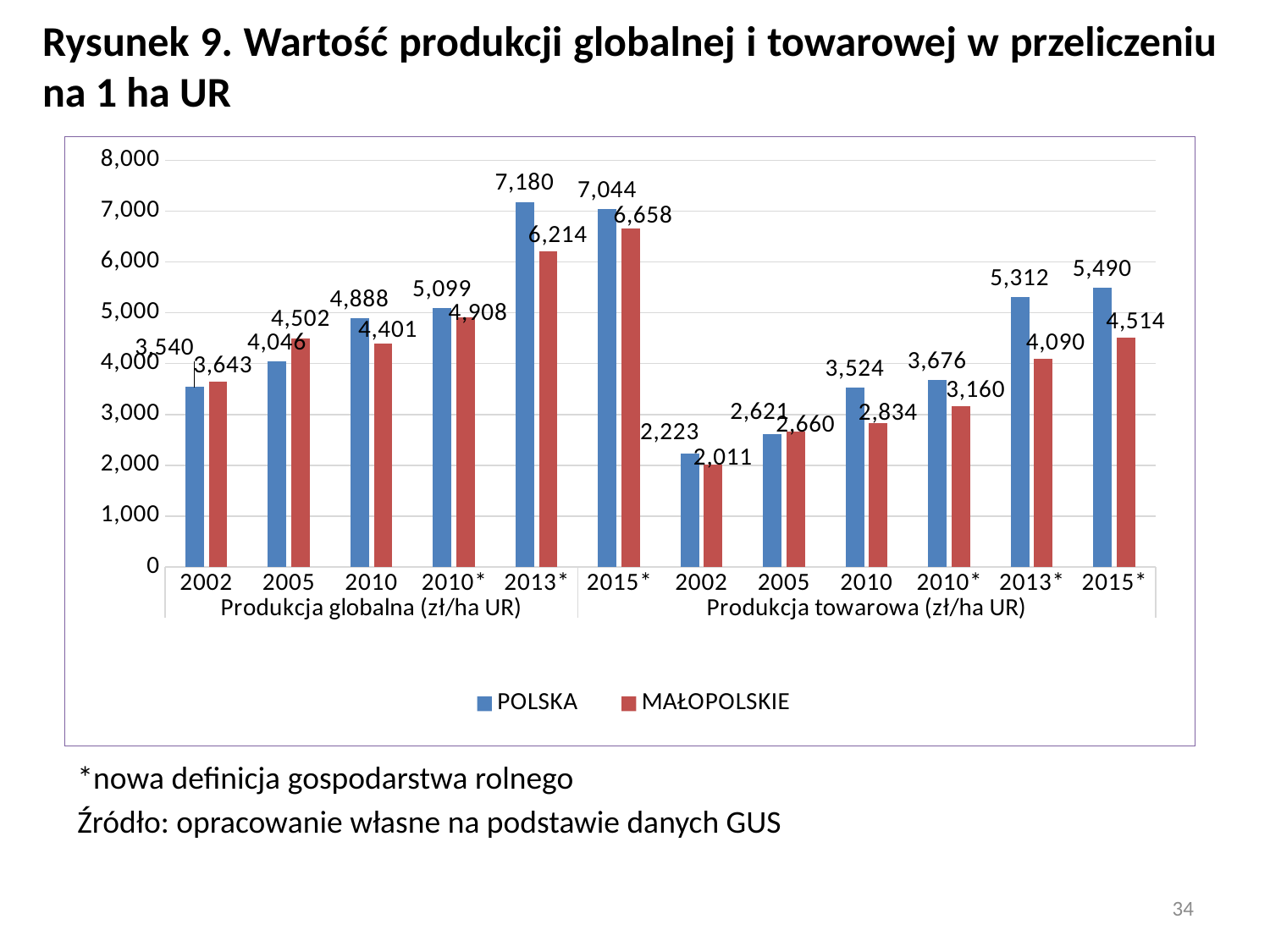
What is the value for MAŁOPOLSKIE in 2015* under Produkcja towarowa (zł/ha UR)? 4,514 How many series does the legend list? 2 What is the difference between the POLSKA and MAŁOPOLSKIE values in 2013* under Produkcja towarowa (zł/ha UR)? 1,222 Is the value for MAŁOPOLSKIE in 2015* under Produkcja globalna (zł/ha UR) greater or less than 6,000? greater Do the POLSKA values under Produkcja towarowa (zł/ha UR) rise or fall from 2002 to 2015*? rise What is the value for MAŁOPOLSKIE in 2002 under Produkcja globalna (zł/ha UR)? 3,643 Which year has the highest POLSKA value under Produkcja globalna (zł/ha UR)? 2013* What kind of chart is shown on the slide? bar chart Which is larger in 2010 under Produkcja globalna (zł/ha UR): POLSKA or MAŁOPOLSKIE? POLSKA What is the value for POLSKA in 2013* under Produkcja globalna (zł/ha UR)? 7,180 Which year has the lowest MAŁOPOLSKIE value under Produkcja towarowa (zł/ha UR)? 2002 Which colour represents MAŁOPOLSKIE in the chart? red